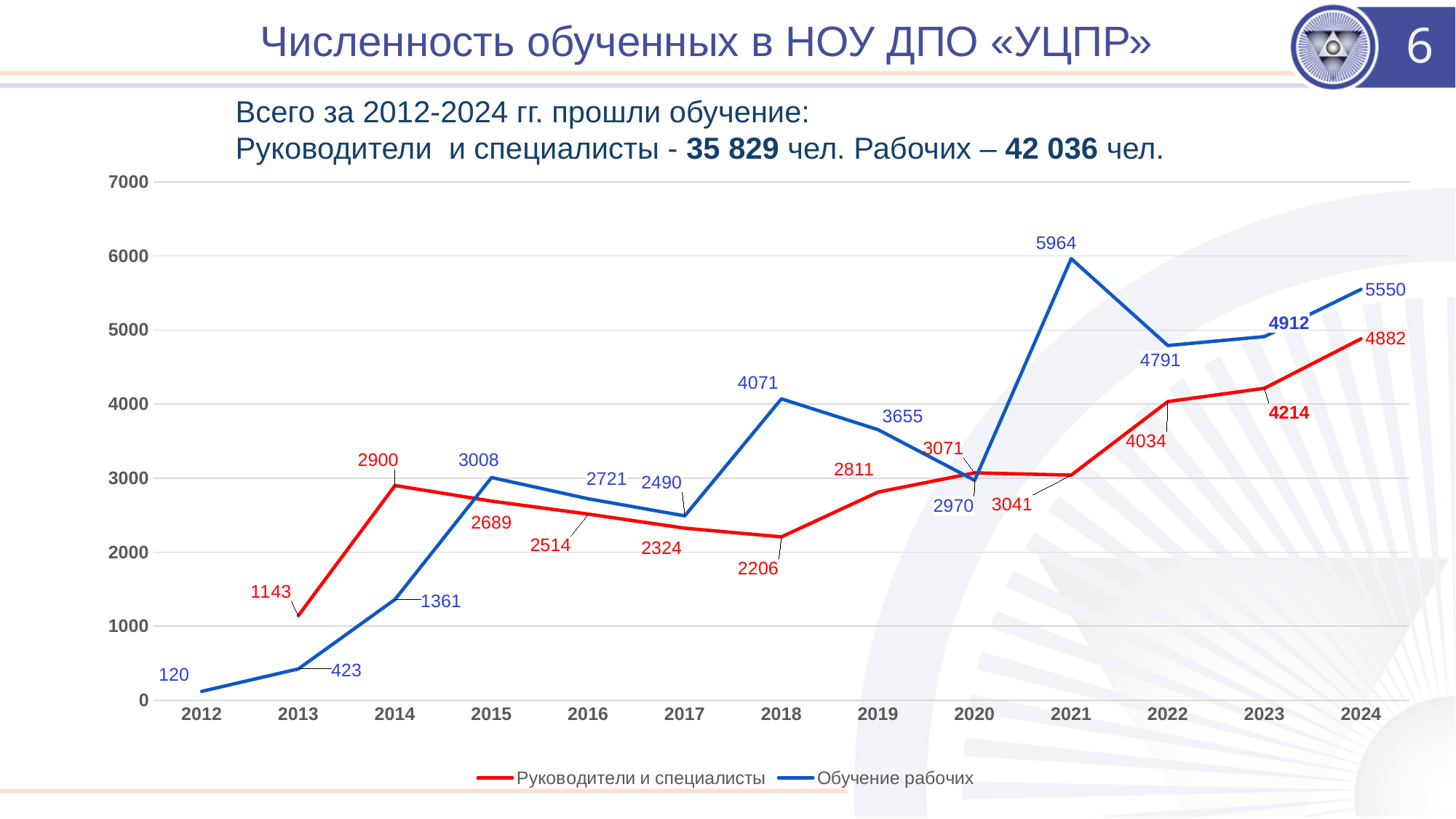
In which year is the Руководители и специалисты series at its lowest value? 2013 What kind of chart is shown on the slide? line chart What is the value for Обучение рабочих in 2021? 5964 What is the value for Руководители и специалисты in 2018? 2206 How many series does the legend list? 2 How many years are shown on the x axis? 13 Is the value for Обучение рабочих in 2019 greater or less than 3000? greater In which year does the Обучение рабочих series reach its highest value? 2021 Does the Руководители и специалисты series rise or fall from 2022 to 2024? rise By how much did Обучение рабочих increase from 2020 to 2021? 2994 In 2015, which series has the larger value: Руководители и специалисты or Обучение рабочих? Обучение рабочих What is the difference between Обучение рабочих and Руководители и специалисты in 2024? 668